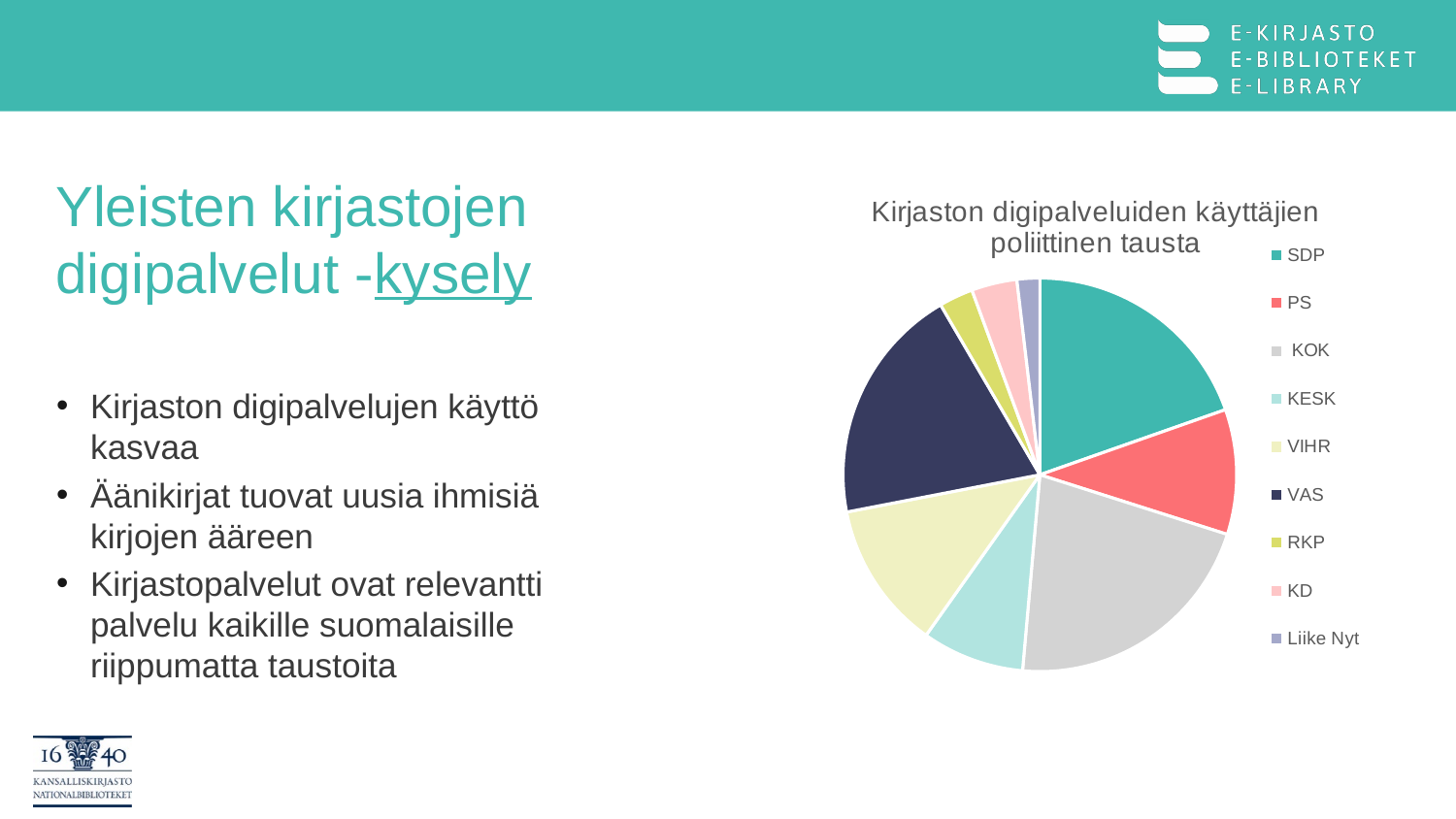
Which is the first entry listed in the chart legend? SDP Which slice is larger, PS or Liike Nyt? PS Which slice is larger, KOK or KESK? KOK How many categories (slices) does the pie chart have? 9 What kind of chart is shown on the slide? pie chart Which slice is larger, VIHR or RKP? VIHR What is the title of the pie chart? Kirjaston digipalveluiden käyttäjien poliittinen tausta